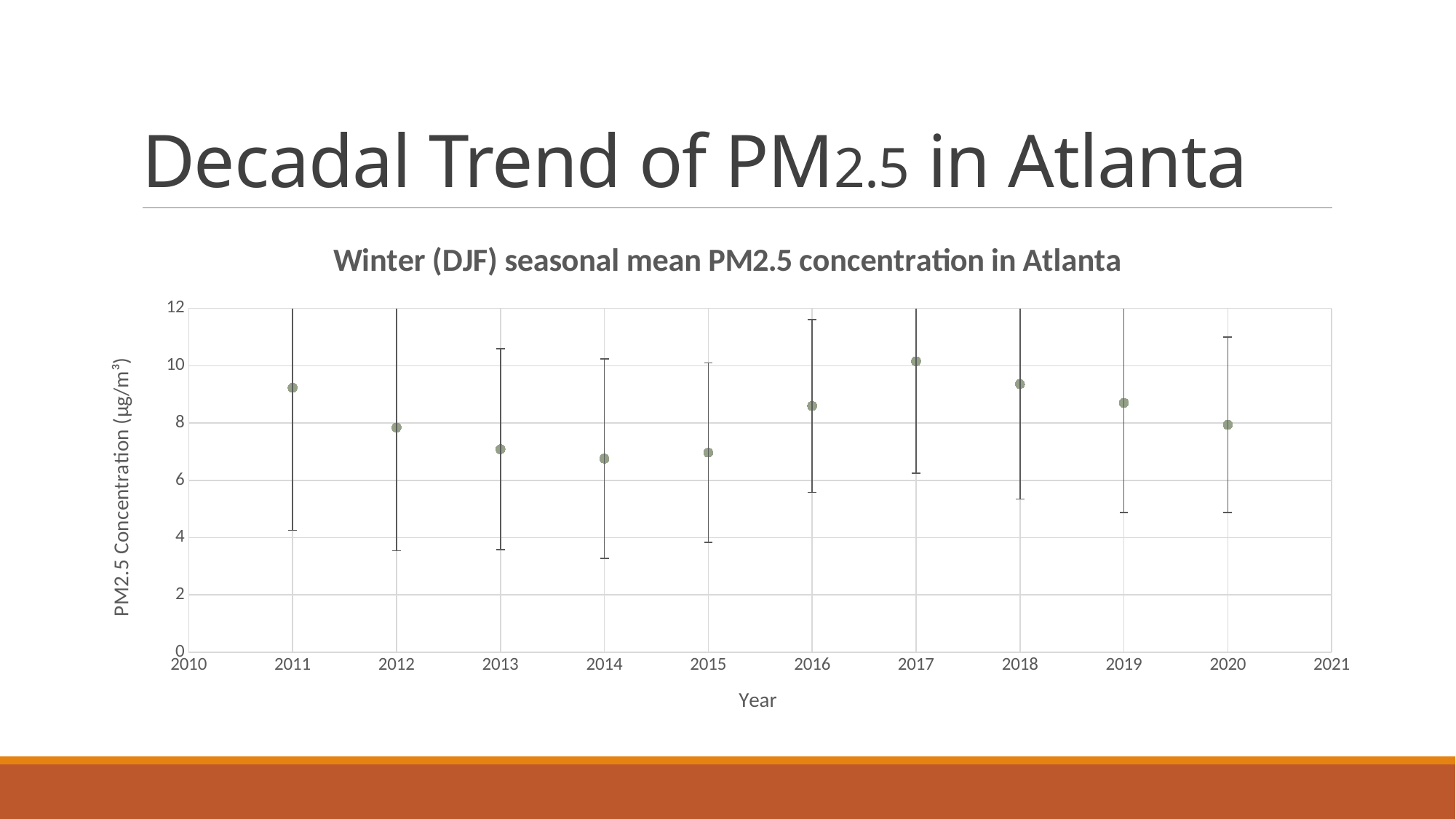
Which year has the larger value, 2011 or 2012? 2011 What kind of chart is shown on the slide? scatter chart Do the values rise or fall from 2014 to 2017? rise Do the values rise or fall from 2011 to 2014? fall How many data points are plotted in the chart? 10 Which year has the larger value, 2016 or 2015? 2016 Is the value for 2014 greater or less than 8? less Is the value for 2013 greater or less than 8? less Is the value for 2018 greater or less than 8? greater Which year has the highest winter mean PM2.5 concentration? 2017 What is the title of the chart? Winter (DJF) seasonal mean PM2.5 concentration in Atlanta